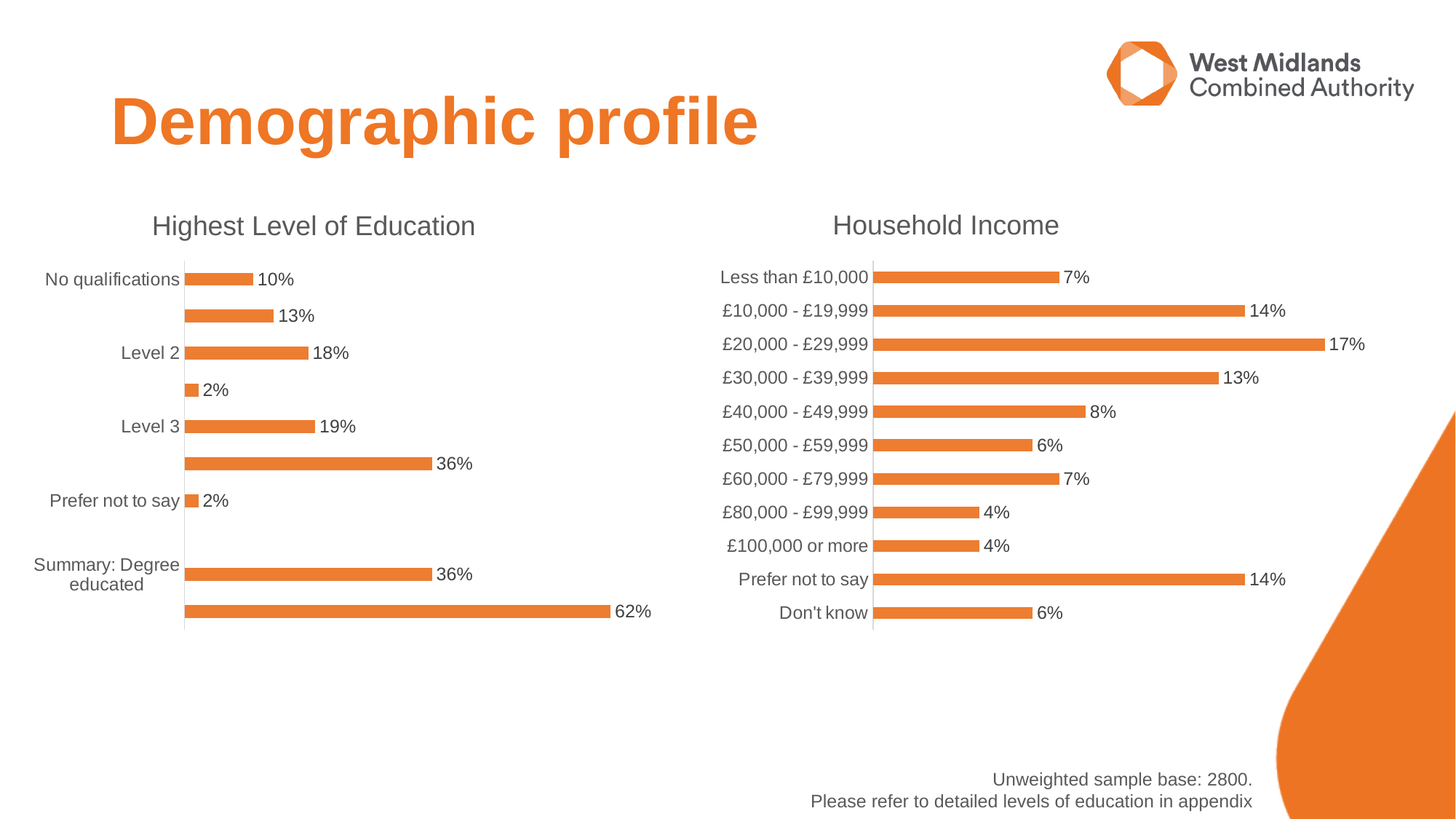
In the Highest Level of Education chart, what is the value for 'Summary: Degree educated'? 36% In the Household Income chart, what percentage of respondents have a household income of £20,000 - £29,999? 17% In the Highest Level of Education chart, what is the value for Level 3? 19% What type of chart is the Household Income chart? Bar chart In the Household Income chart, what is the difference in percentage points between £10,000 - £19,999 and £40,000 - £49,999? 6 How many categories are shown in the Household Income chart? 11 In the Highest Level of Education chart, what is the difference in percentage points between Level 3 and Level 2? 1 In the Household Income chart, which income band has the highest percentage? £20,000 - £29,999 In the Household Income chart, what percentage of respondents answered 'Don't know'? 6% In the Household Income chart, which is larger: the value for £30,000 - £39,999 or the value for £60,000 - £79,999? £30,000 - £39,999 What is the unweighted sample base stated on the slide? 2800 In the Highest Level of Education chart, what percentage of respondents have no qualifications? 10%